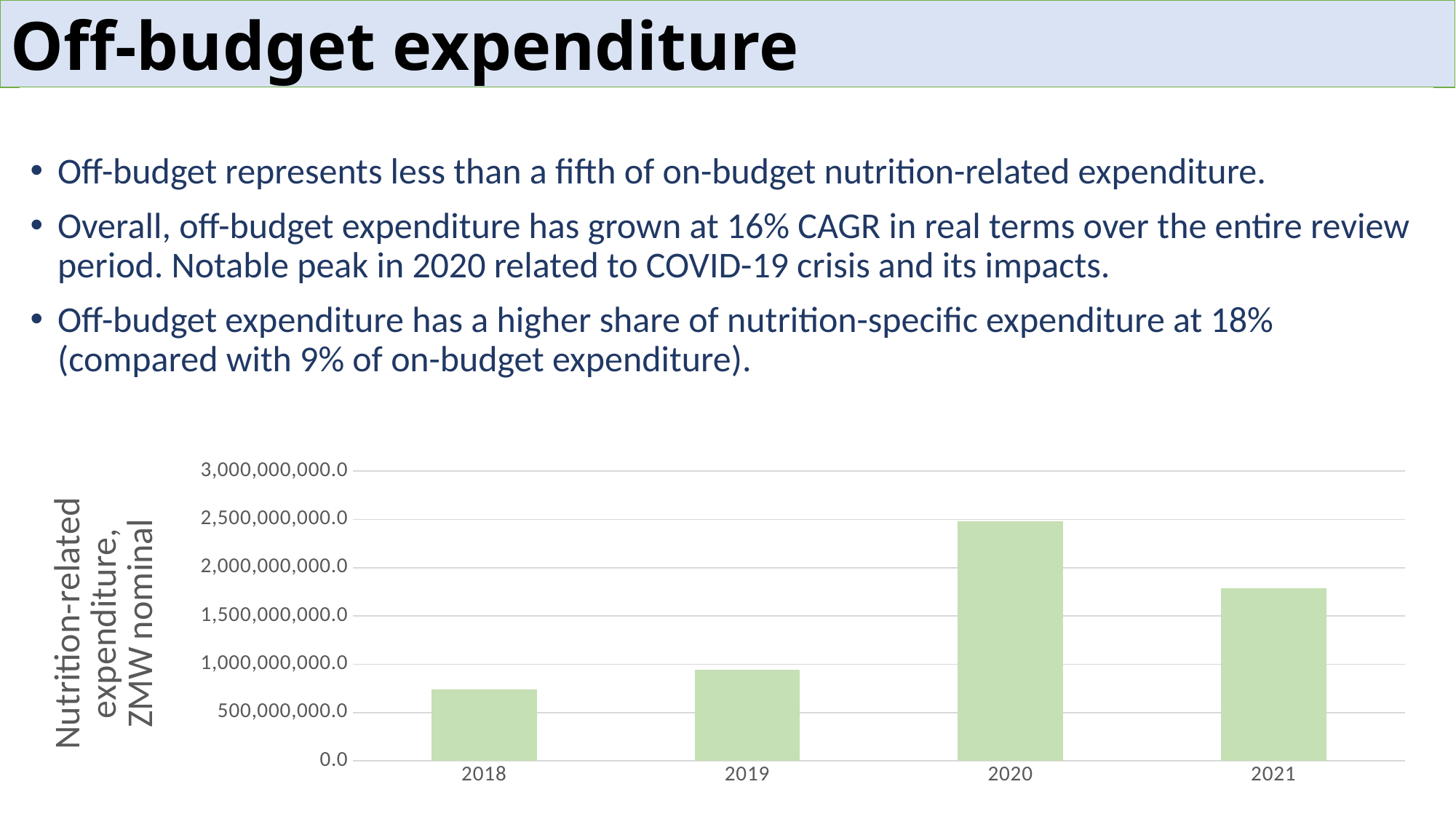
Is the value for 2018 greater or less than 1,000,000,000.0? less Which year has the lowest nutrition-related expenditure in the chart? 2018 Is the value for 2021 greater or less than 1,500,000,000.0? greater Which year has the larger expenditure, 2018 or 2019? 2019 Which year has the highest nutrition-related expenditure in the chart? 2020 Is the value for 2018 greater or less than 500,000,000.0? greater How many years are shown on the x axis of the chart? 4 What is the label on the vertical axis of the chart? Nutrition-related expenditure, ZMW nominal What kind of chart is shown on the slide? bar chart Which year has the larger expenditure, 2020 or 2021? 2020